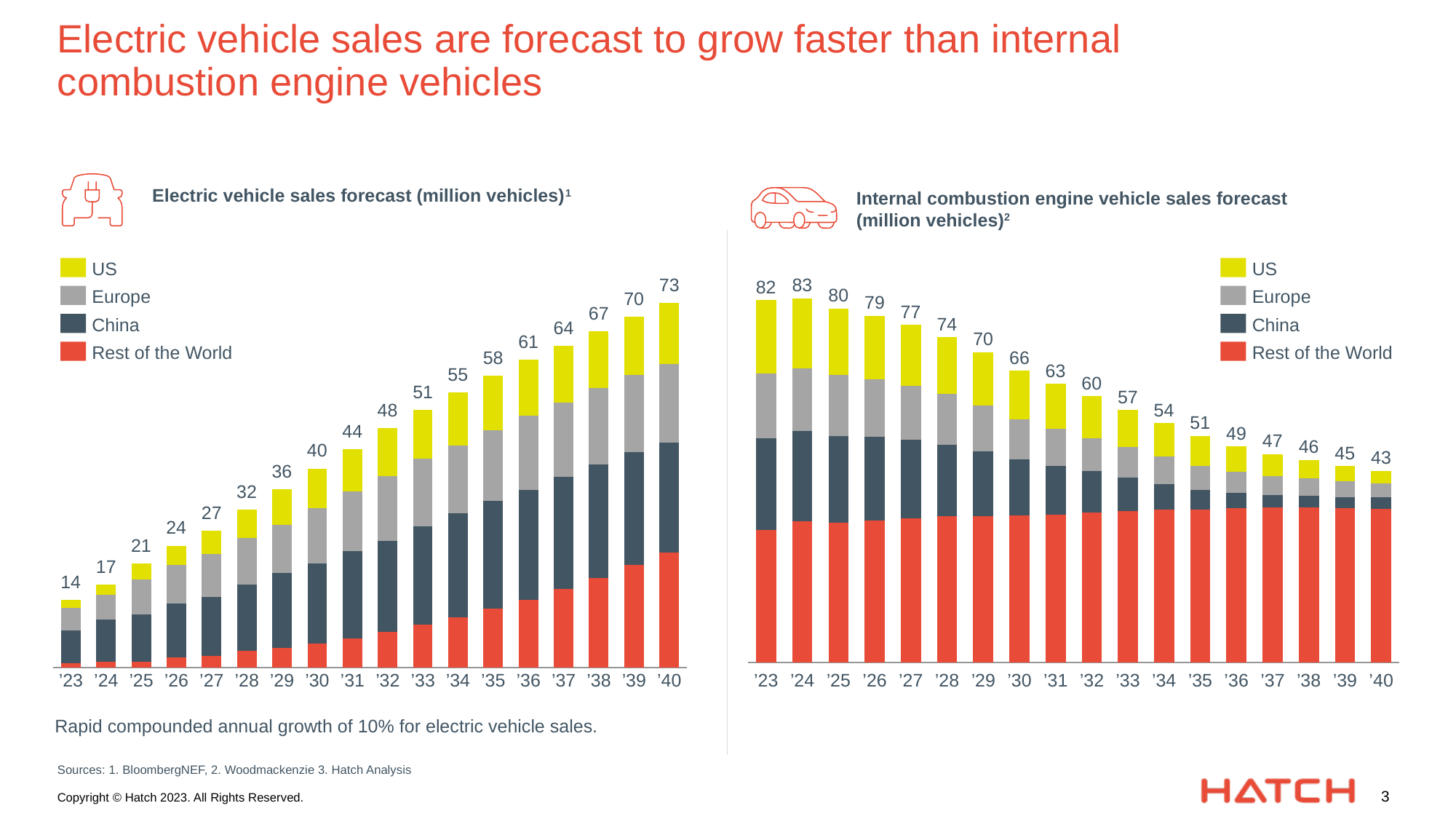
In the Internal combustion engine vehicle sales forecast chart, what is the total forecast for '24? 83 In the Electric vehicle sales forecast chart, do the totals rise or fall from '23 to '40? rise In the Electric vehicle sales forecast chart, what is the difference between the totals for '40 and '23? 59 Which is larger: the Electric vehicle total for '35 or the Internal combustion engine vehicle total for '35? Electric vehicle total for '35 In the Electric vehicle sales forecast chart, which year has the lowest total? '23 How many series does the legend of the Internal combustion engine vehicle sales forecast chart list? 4 What kind of chart is the Electric vehicle sales forecast chart? stacked bar chart In the Electric vehicle sales forecast chart, what is the total forecast for '23? 14 In the Internal combustion engine vehicle sales forecast chart, what is the difference between the totals for '23 and '40? 39 In the Internal combustion engine vehicle sales forecast chart, which year has the highest total? '24 In the Electric vehicle sales forecast chart, what is the total forecast for '40? 73